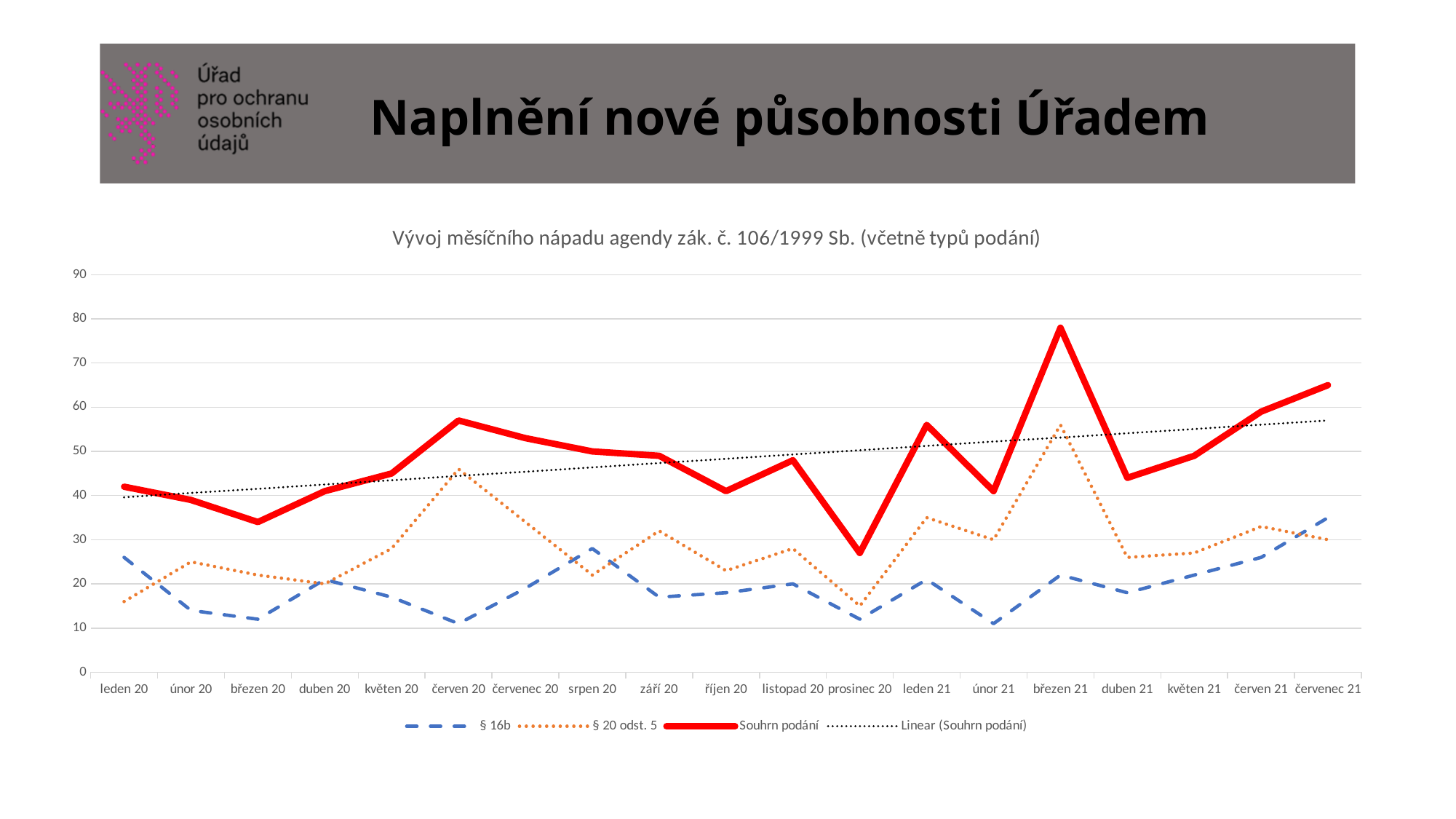
Does the Linear (Souhrn podání) trendline rise or fall from leden 20 to červenec 21? rise How many months are shown on the x axis? 19 Is the value of § 20 odst. 5 in červen 20 greater or less than 40? greater What kind of chart is shown on the slide? line chart What is the title of the chart? Vývoj měsíčního nápadu agendy zák. č. 106/1999 Sb. (včetně typů podání) How many series does the legend list? 4 In which month does the § 20 odst. 5 series reach its highest value? březen 21 Is the value of Souhrn podání in březen 21 greater or less than 70? greater Which is higher for Souhrn podání: červen 20 or březen 20? červen 20 In which month does the Souhrn podání series reach its lowest value? prosinec 20 Is the value of Souhrn podání in prosinec 20 greater or less than 30? less In which month does the Souhrn podání series reach its highest value? březen 21